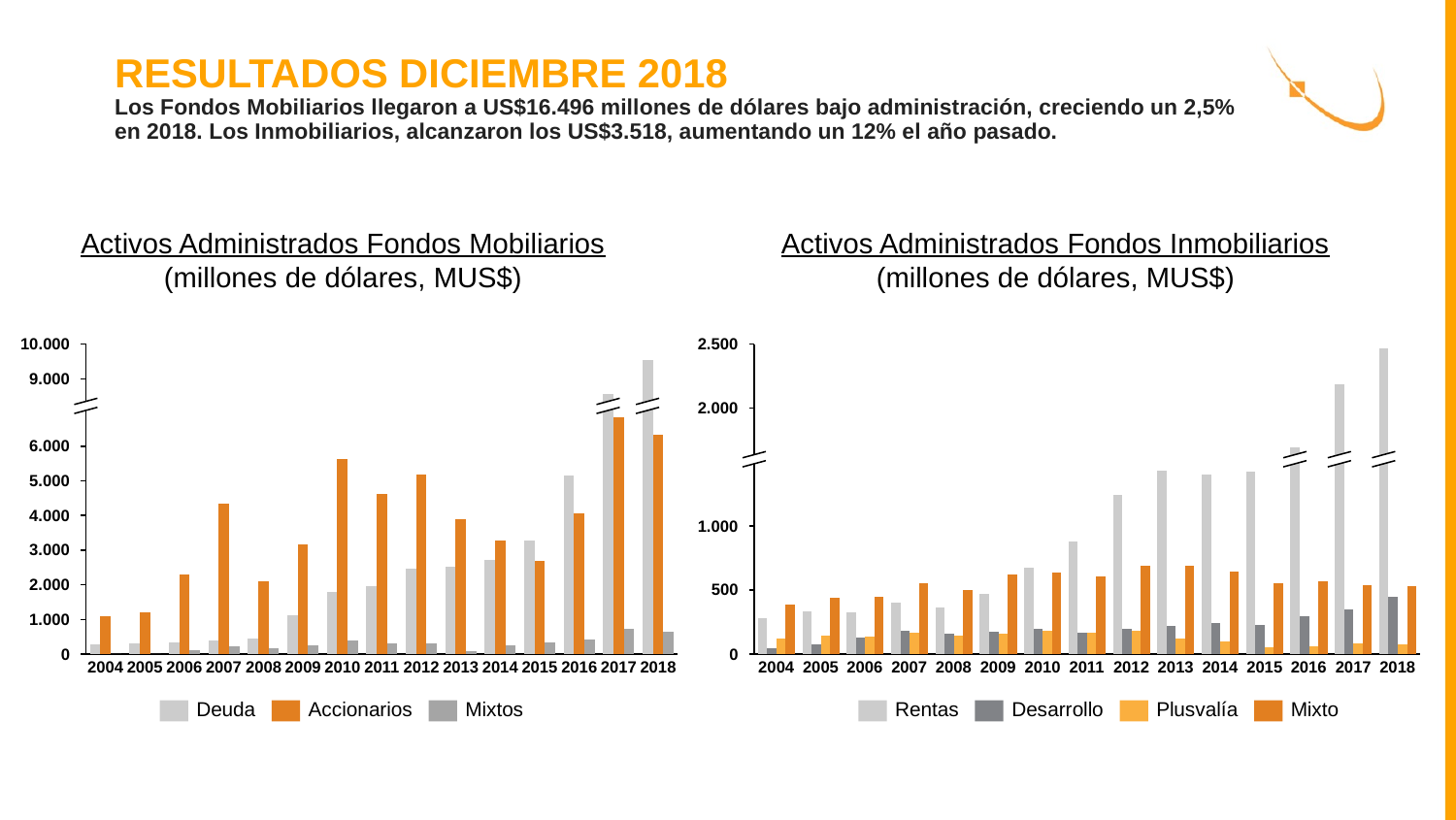
In the 'Activos Administrados Fondos Mobiliarios' chart, which year has the highest Deuda value? 2018 In the 'Activos Administrados Fondos Inmobiliarios' chart, which year has the highest Rentas value? 2018 How many series does the legend of the 'Activos Administrados Fondos Mobiliarios' chart list? 3 What kind of chart is the 'Activos Administrados Fondos Mobiliarios' chart? bar chart In the 'Activos Administrados Fondos Inmobiliarios' chart, is the Rentas value for 2004 greater or less than 500? less In the 'Activos Administrados Fondos Inmobiliarios' chart, does the Rentas series generally rise or fall from 2004 to 2018? rise How many series does the legend of the 'Activos Administrados Fondos Inmobiliarios' chart list? 4 In the 'Activos Administrados Fondos Mobiliarios' chart, which is larger: the Accionarios value for 2007 or for 2008? 2007 In the 'Activos Administrados Fondos Mobiliarios' chart, is the Accionarios value for 2010 greater or less than 5.000? greater What are the legend entries of the 'Activos Administrados Fondos Inmobiliarios' chart? Rentas, Desarrollo, Plusvalía, Mixto How many years are shown on the x axis of the 'Activos Administrados Fondos Inmobiliarios' chart? 15